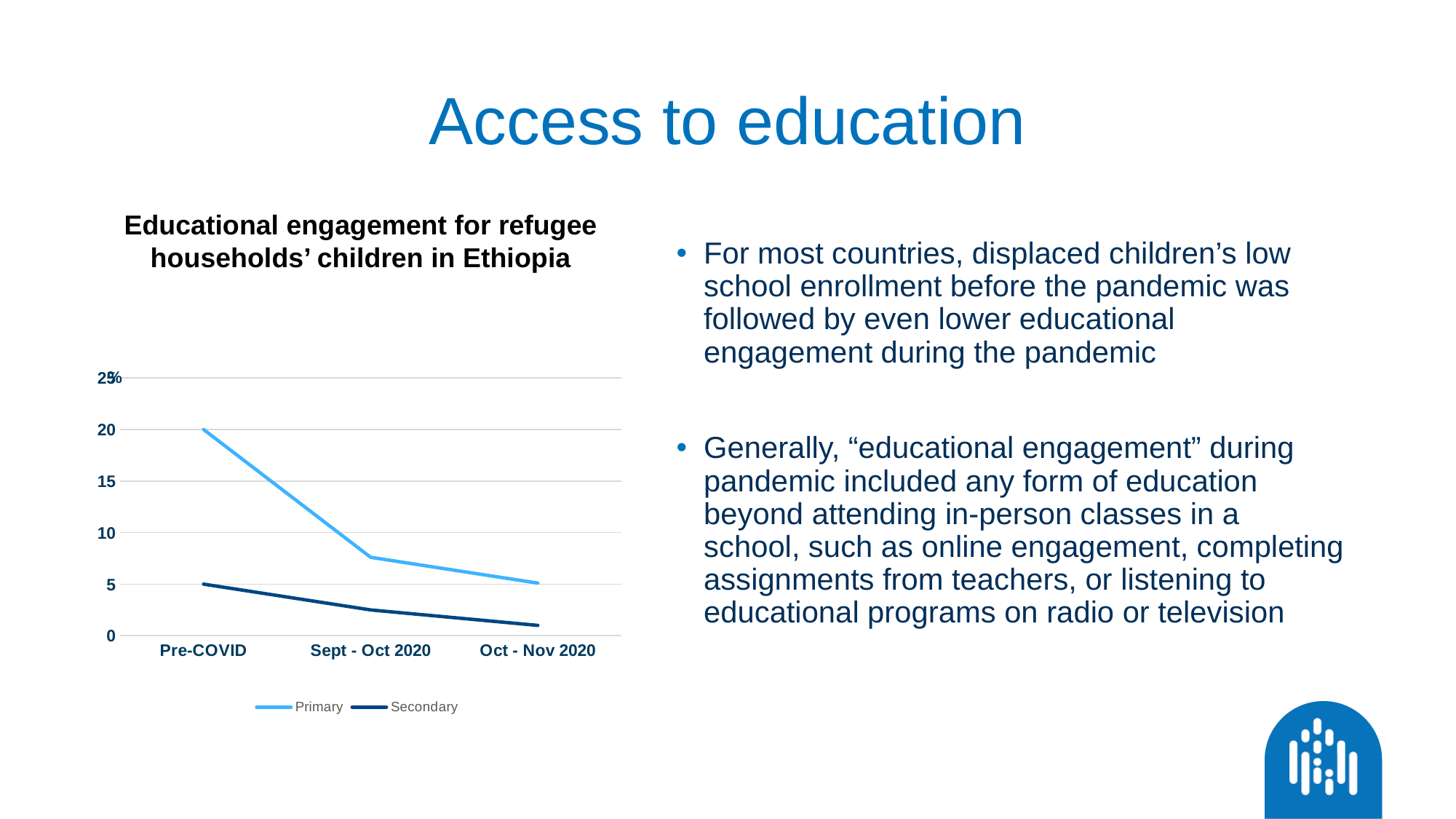
Is the Secondary value for Oct - Nov 2020 greater or less than 5? less What kind of chart is shown on the slide? line chart For Pre-COVID, which series has the larger value, Primary or Secondary? Primary How many series does the chart legend list? 2 What is the Secondary value for Pre-COVID? 5 What is the difference between the Primary and Secondary values for Pre-COVID? 15 Is the Primary value for Sept - Oct 2020 greater or less than 10? less What is the Primary value for Pre-COVID? 20 How many time periods are shown on the x axis of the chart? 3 Does the Primary line rise or fall from Pre-COVID to Oct - Nov 2020? fall In which period is the Primary value highest? Pre-COVID Does the Secondary line rise or fall across the periods shown? fall